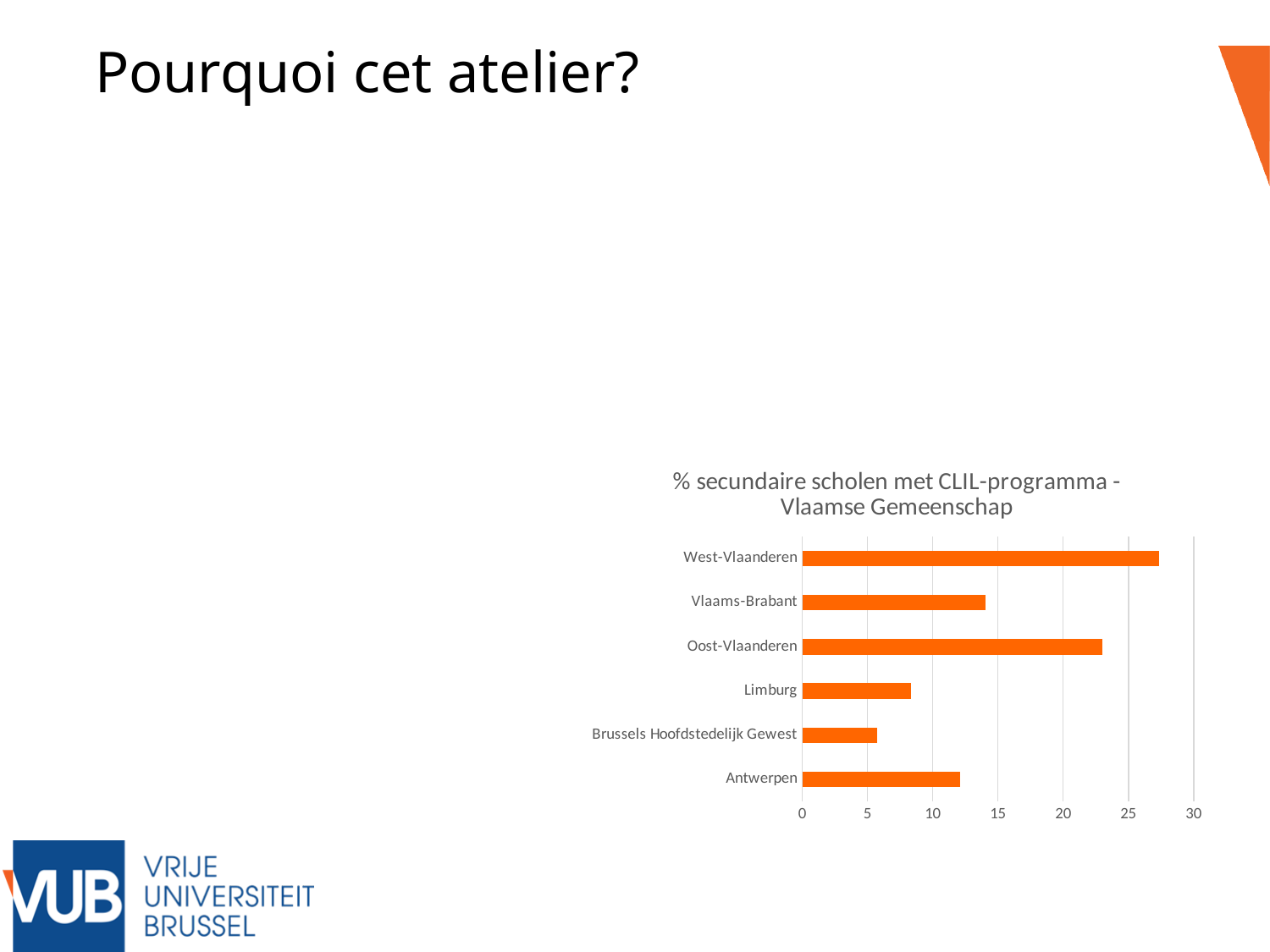
What kind of chart is shown on the slide? bar chart Is the value for Brussels Hoofdstedelijk Gewest greater or less than 10? less Which has the larger value, Oost-Vlaanderen or Vlaams-Brabant? Oost-Vlaanderen Which region has the lowest value in the chart? Brussels Hoofdstedelijk Gewest How many categories (regions) are plotted in the chart? 6 Which has the larger value, Antwerpen or Limburg? Antwerpen Is the value for Oost-Vlaanderen greater or less than 20? greater Is the value for Limburg greater or less than 10? less Which region has the highest value in the chart? West-Vlaanderen What is the highest value shown on the chart's horizontal axis? 30 What is the title of the chart? % secundaire scholen met CLIL-programma - Vlaamse Gemeenschap